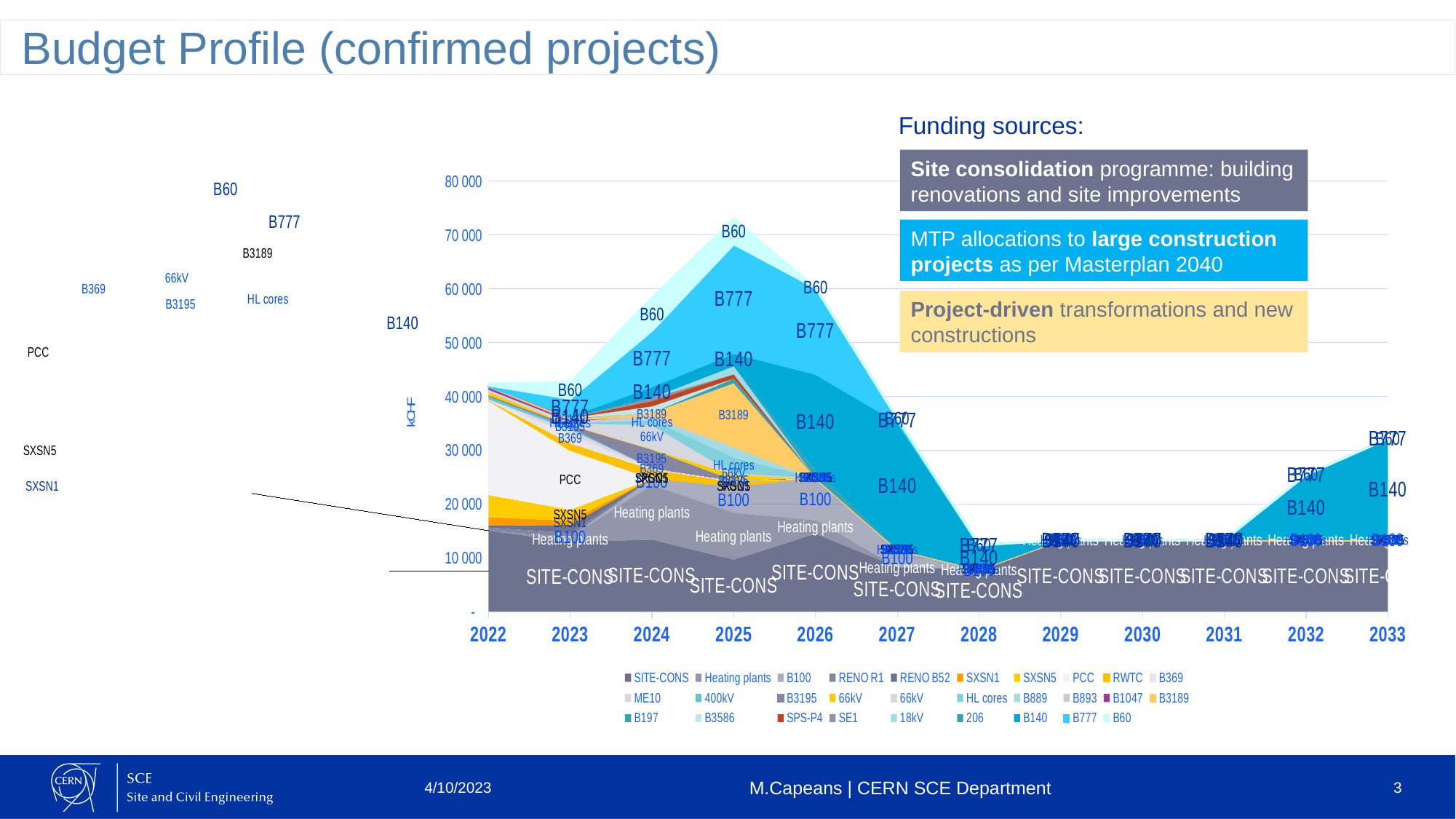
What unit is shown on the y axis of the chart? kCHF Is the total budget in 2027 greater or less than 30 000? greater Is the total budget in 2025 greater or less than 60 000? greater In which year does the total budget reach its highest value? 2025 Does the total budget rise or fall from 2025 to 2028? fall Is the total budget in 2028 greater or less than 20 000? less What kind of chart is shown on the slide? Stacked area chart Which year has the larger total budget, 2024 or 2032? 2024 What is the first year shown on the x axis of the chart? 2022 How many years are shown along the x axis of the chart? 12 In which year is the total budget lowest? 2028